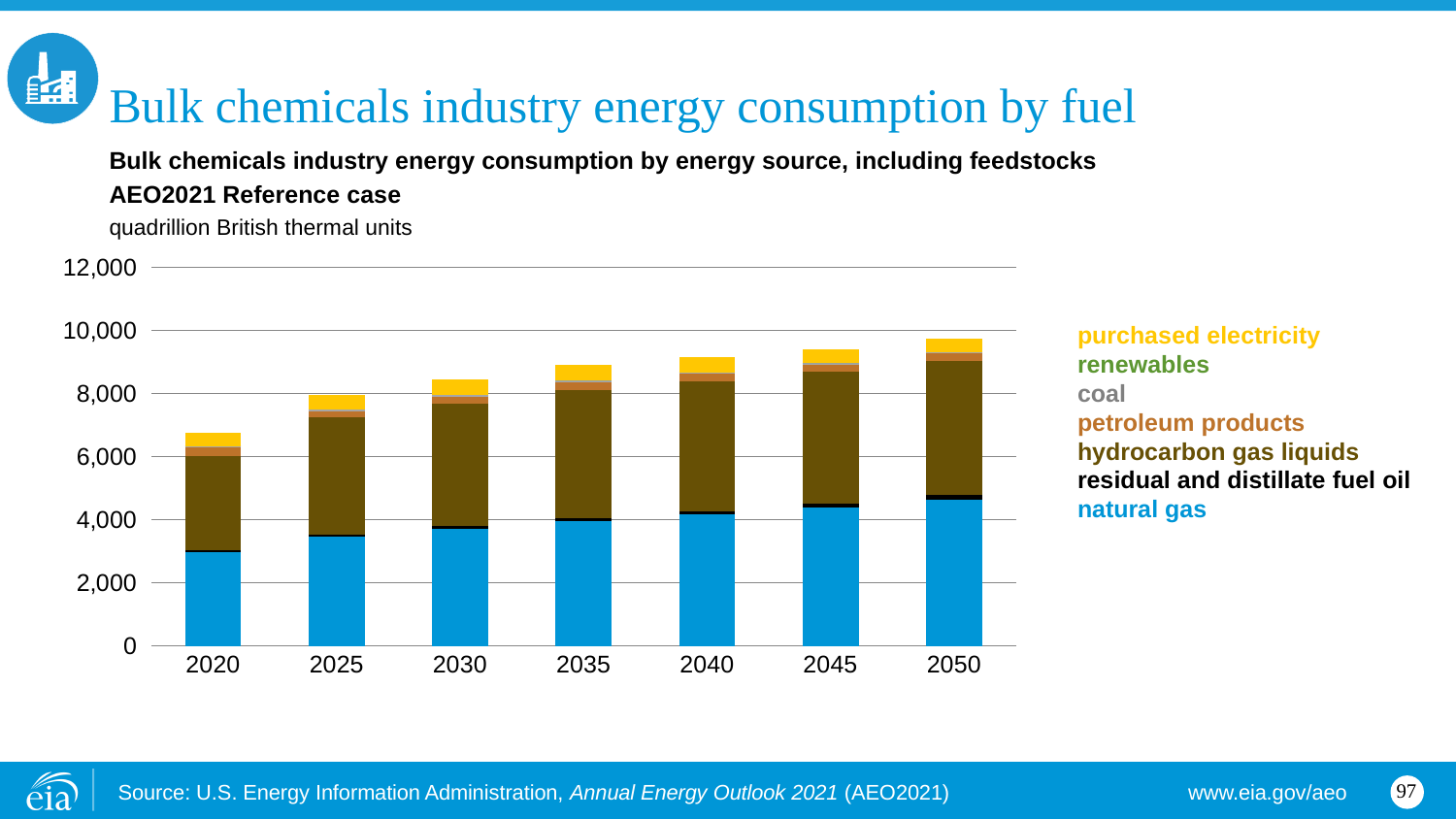
Is the total energy consumption in 2020 greater or less than 8,000 quadrillion Btu? less What unit is the chart's y axis measured in? quadrillion British thermal units Which year has the highest total bulk chemicals energy consumption? 2050 Do the total bar heights rise or fall from 2020 to 2050? rise Which energy source is shown in blue at the bottom of each bar? natural gas Which year has the larger total energy consumption, 2020 or 2050? 2050 How many energy sources does the legend list? 7 Is the total energy consumption in 2050 greater or less than 8,000 quadrillion Btu? greater Which year has the lowest total bulk chemicals energy consumption? 2020 What kind of chart is shown on the slide? stacked bar chart How many years are shown along the x axis of the chart? 7 Is the natural gas consumption in 2050 greater or less than 4,000 quadrillion Btu? greater